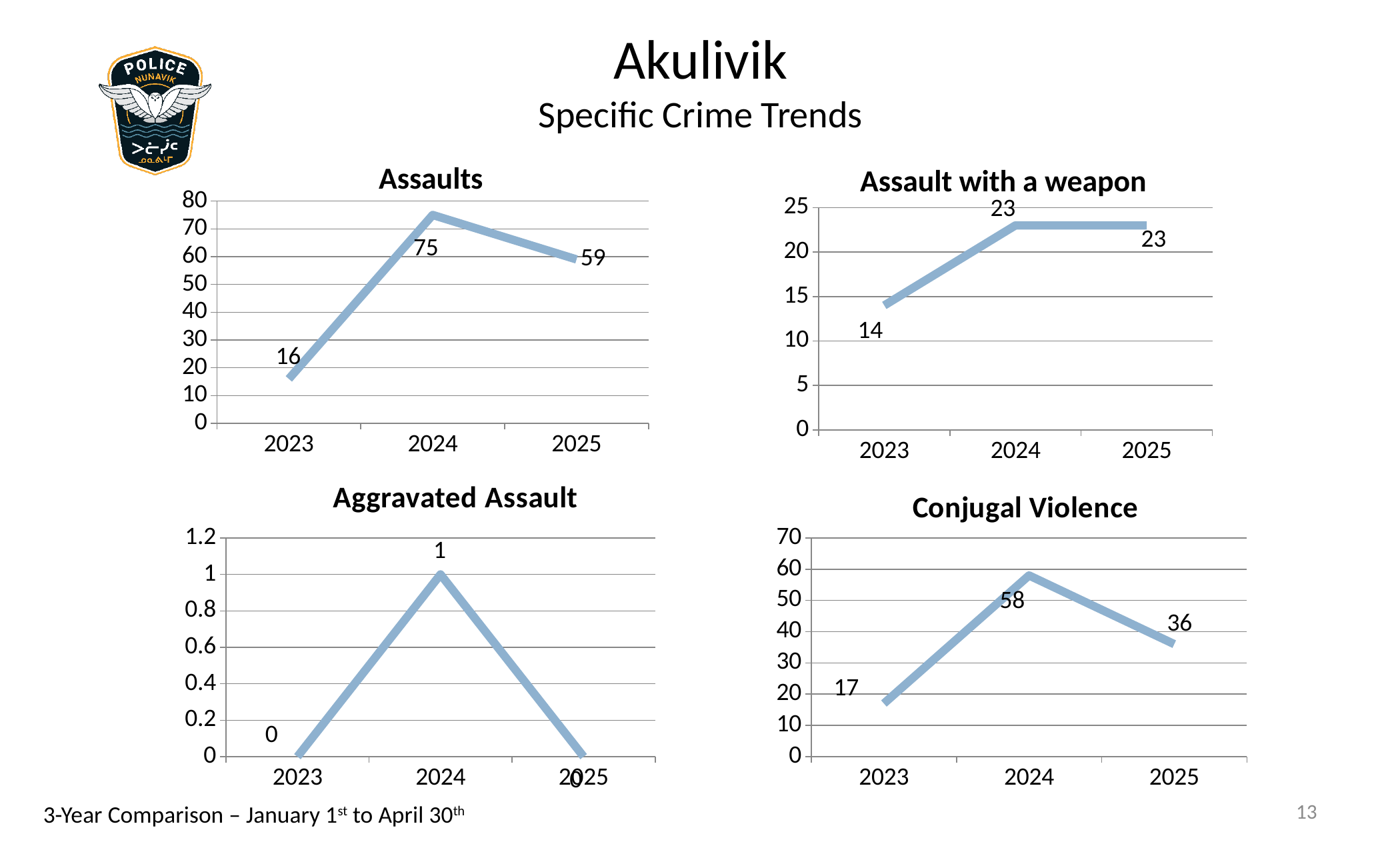
In the Assaults chart, what is the difference between the 2024 and 2025 values? 16 In the Assault with a weapon chart, what is the value for 2023? 14 In the Aggravated Assault chart, what is the value for 2024? 1 In the Assaults chart, what is the value for 2024? 75 In the Aggravated Assault chart, what is the value for 2023? 0 What kind of chart is the Assaults chart? line chart In the Assaults chart, which year has the lowest value? 2023 In the Conjugal Violence chart, is the value for 2025 greater or less than 40? less In the Assault with a weapon chart, is the value for 2024 larger than, smaller than, or equal to the value for 2025? equal In the Conjugal Violence chart, what is the difference between the 2024 and 2023 values? 41 How many years are plotted on the x axis of the Assault with a weapon chart? 3 In the Conjugal Violence chart, which year has the highest value? 2024